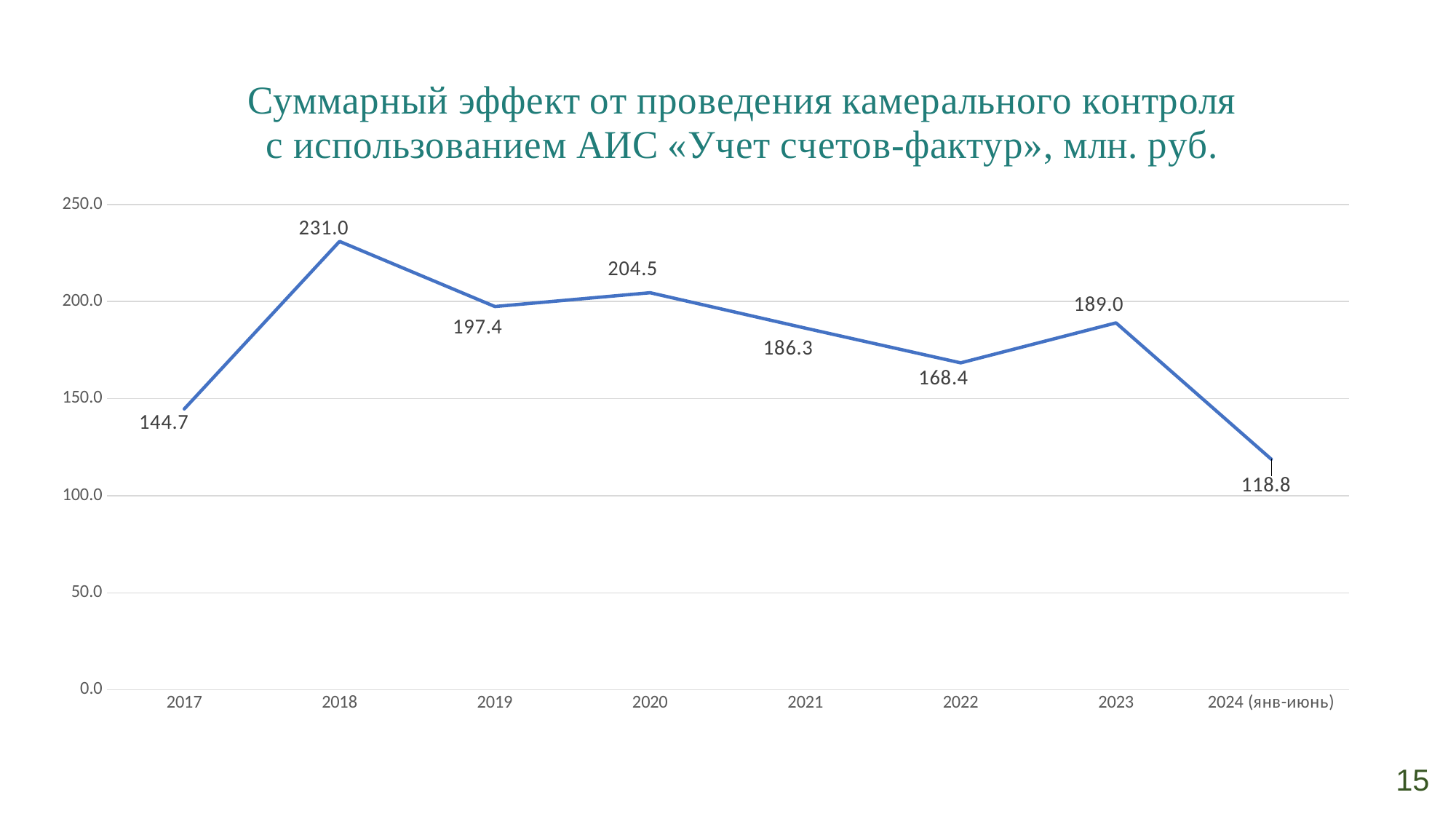
What is the value for 2022? 168.4 What unit is stated in the chart title? млн. руб. What is the value for 2018? 231.0 Is the value for 2021 greater or less than 200.0? less How many data points are plotted on the chart? 8 What is the difference between the values for 2018 and 2017? 86.3 Which year has the highest value? 2018 What kind of chart is shown on the slide? line chart What is the value for 2024 (янв-июнь)? 118.8 Which is larger, the value for 2020 or the value for 2023? 2020 Which category has the lowest value? 2024 (янв-июнь) Does the value rise or fall from 2023 to 2024 (янв-июнь)? fall